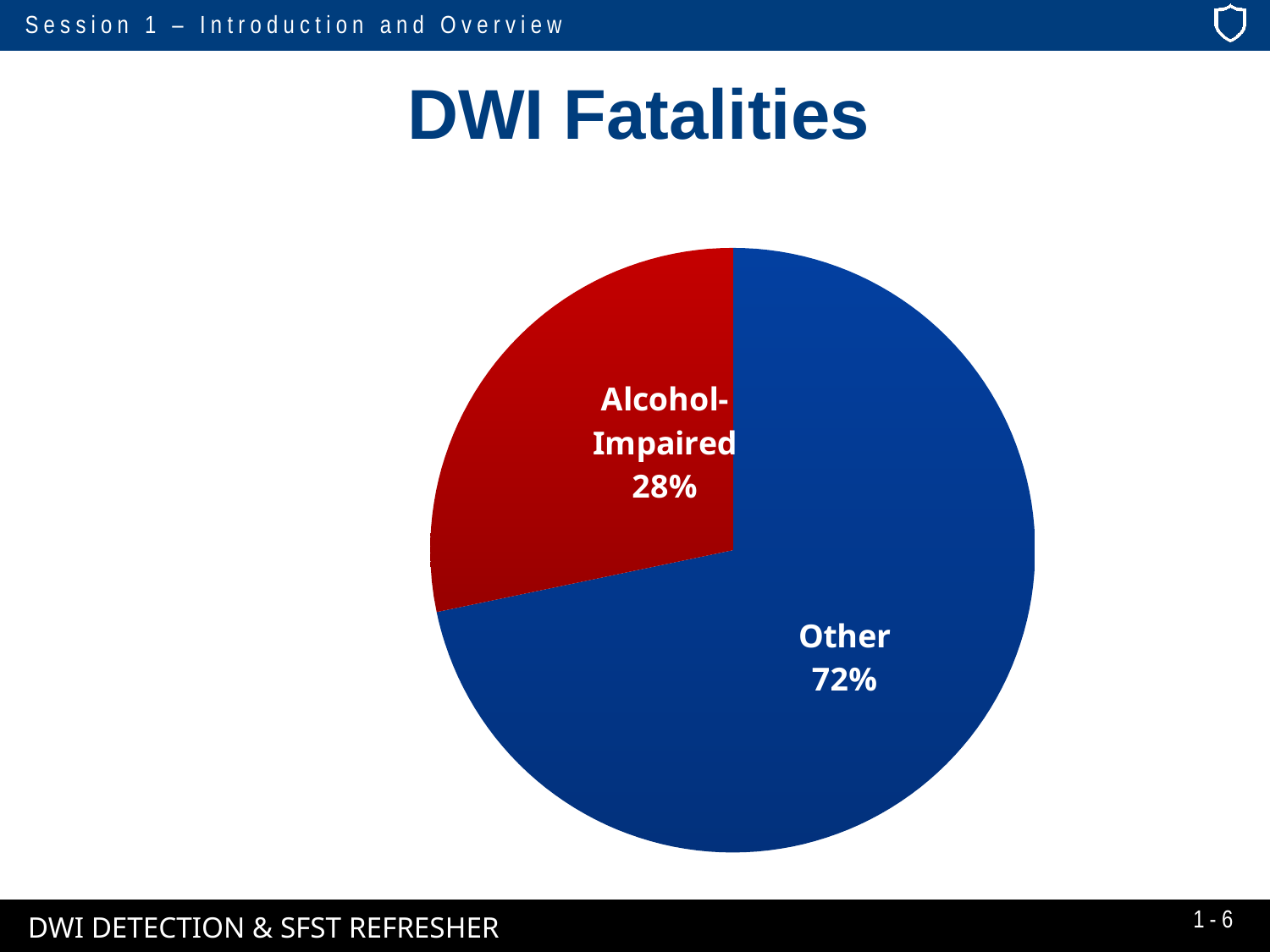
How many slices does the pie chart have? 2 Which slice of the pie is the smallest? Alcohol-Impaired Which slice of the pie is the largest? Other Is the Alcohol-Impaired share greater or less than 50%? less What is the difference in percentage points between the Other slice and the Alcohol-Impaired slice? 44 What kind of chart is shown on the slide? Pie chart What share of DWI fatalities is labelled Other? 72% What is the title of the chart? DWI Fatalities What do the two slices of the pie add up to? 100% What share of DWI fatalities is Alcohol-Impaired? 28% Which is larger, the Alcohol-Impaired slice or the Other slice? Other What colour is the Alcohol-Impaired slice? Red